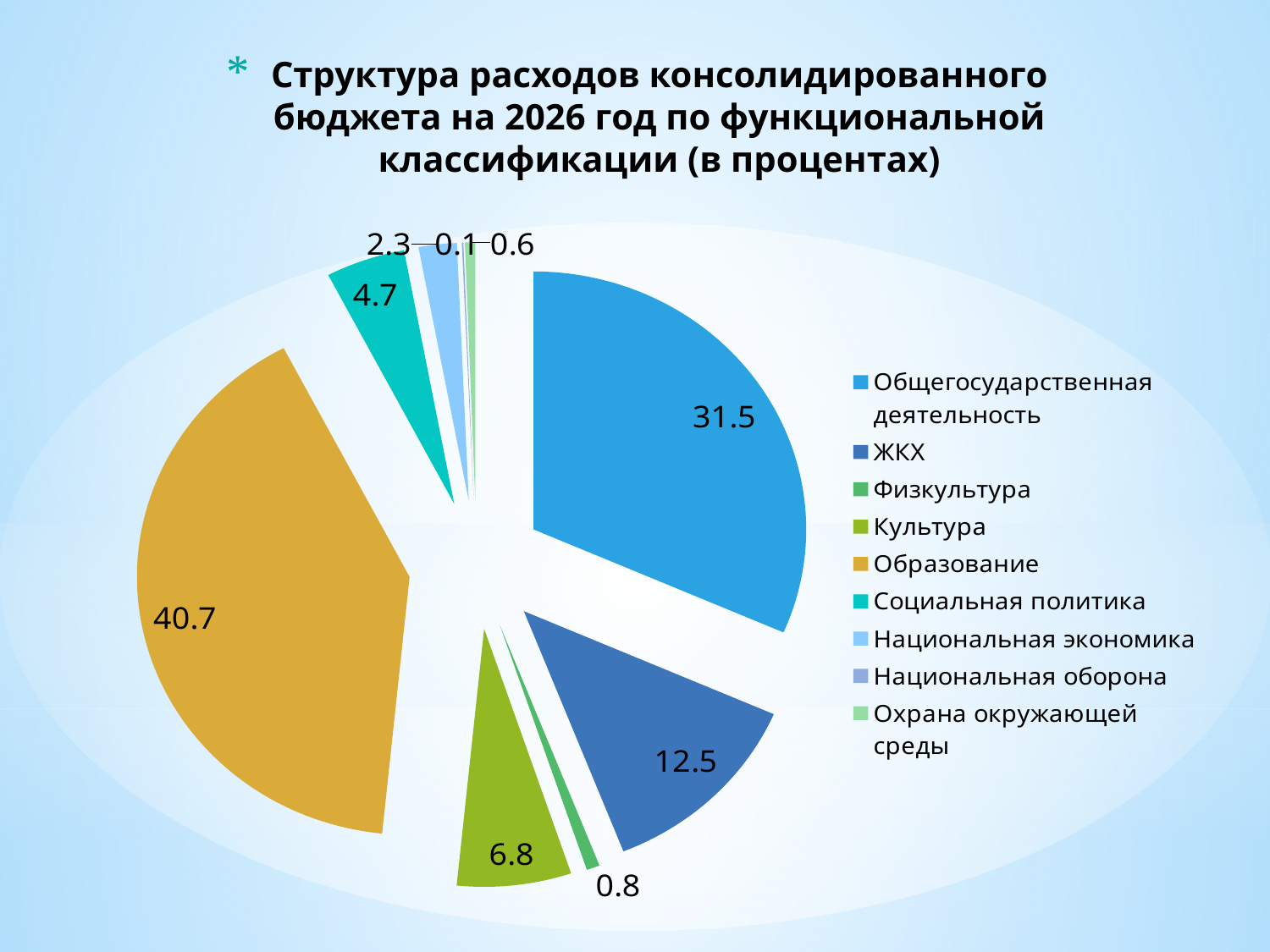
What is the difference between the values for Образование and Общегосударственная деятельность? 9.2 What is the value for Национальная оборона? 0.1 What is the value for Образование? 40.7 What is the title of the chart? Структура расходов консолидированного бюджета на 2026 год по функциональной классификации (в процентах) What is the value for ЖКХ? 12.5 Which category has the smallest share of the pie? Национальная оборона What type of chart is shown on the slide? pie chart Which category has the largest share of the pie? Образование What is the value for Социальная политика? 4.7 How many categories does the legend list? 9 Which is larger, the value for Культура or the value for Социальная политика? Культура What is the value for Общегосударственная деятельность? 31.5